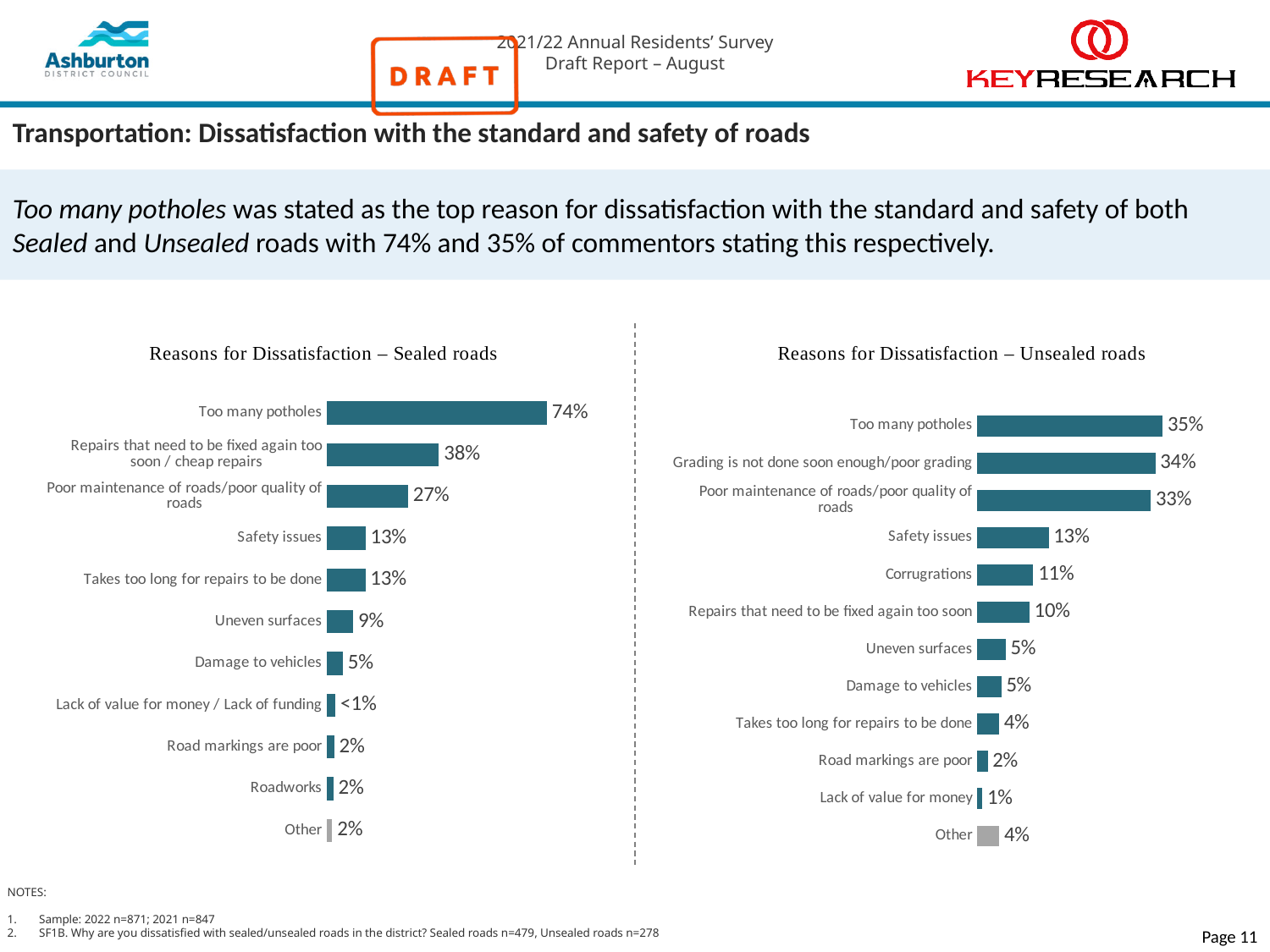
How many reasons are listed in the 'Reasons for Dissatisfaction – Unsealed roads' chart? 12 In the 'Reasons for Dissatisfaction – Unsealed roads' chart, what is the value for Grading is not done soon enough/poor grading? 34% In the 'Reasons for Dissatisfaction – Unsealed roads' chart, which reason has the highest value? Too many potholes In the 'Reasons for Dissatisfaction – Sealed roads' chart, which reason has the lowest value? Lack of value for money / Lack of funding How many reasons are listed in the 'Reasons for Dissatisfaction – Sealed roads' chart? 11 In the 'Reasons for Dissatisfaction – Unsealed roads' chart, what is the value for Corrugations? 11% In the 'Reasons for Dissatisfaction – Unsealed roads' chart, what is the difference between Too many potholes and Poor maintenance of roads/poor quality of roads? 2% In the 'Reasons for Dissatisfaction – Sealed roads' chart, what is the value for Repairs that need to be fixed again too soon / cheap repairs? 38% In the 'Reasons for Dissatisfaction – Sealed roads' chart, what is the value for Too many potholes? 74% What type of chart is the 'Reasons for Dissatisfaction – Sealed roads' chart? Bar chart In the 'Reasons for Dissatisfaction – Sealed roads' chart, what is the difference between Too many potholes and Repairs that need to be fixed again too soon / cheap repairs? 36% In the 'Reasons for Dissatisfaction – Unsealed roads' chart, which is larger: Uneven surfaces or Takes too long for repairs to be done? Uneven surfaces